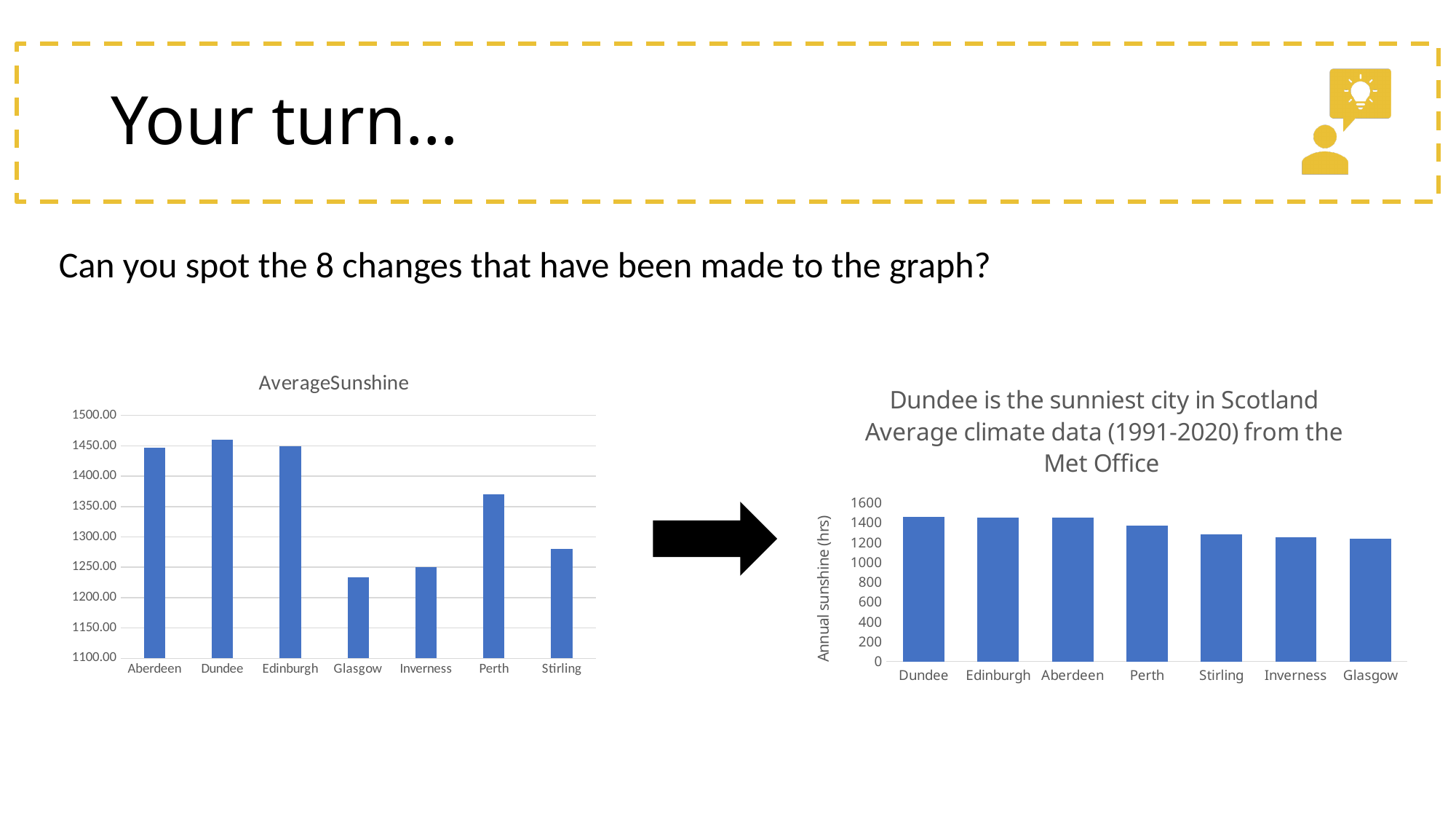
On the right chart, which city has the lowest annual sunshine? Glasgow On the left chart titled "AverageSunshine", is the value for Perth greater or less than 1350.00? greater What is the y-axis title on the right chart? Annual sunshine (hrs) On the right chart, which city has the highest annual sunshine? Dundee On the left chart titled "AverageSunshine", which city has the lowest value? Glasgow What is the title of the left chart? AverageSunshine On the left chart titled "AverageSunshine", is the value for Stirling greater or less than 1250.00? greater What kind of chart is the left chart titled "AverageSunshine"? bar chart How many cities are shown on the left chart titled "AverageSunshine"? 7 On the right chart, do the bars rise or fall from left to right along the x axis? fall On the left chart titled "AverageSunshine", which is larger, the value for Perth or the value for Stirling? Perth On the left chart titled "AverageSunshine", is the value for Glasgow greater or less than 1250.00? less